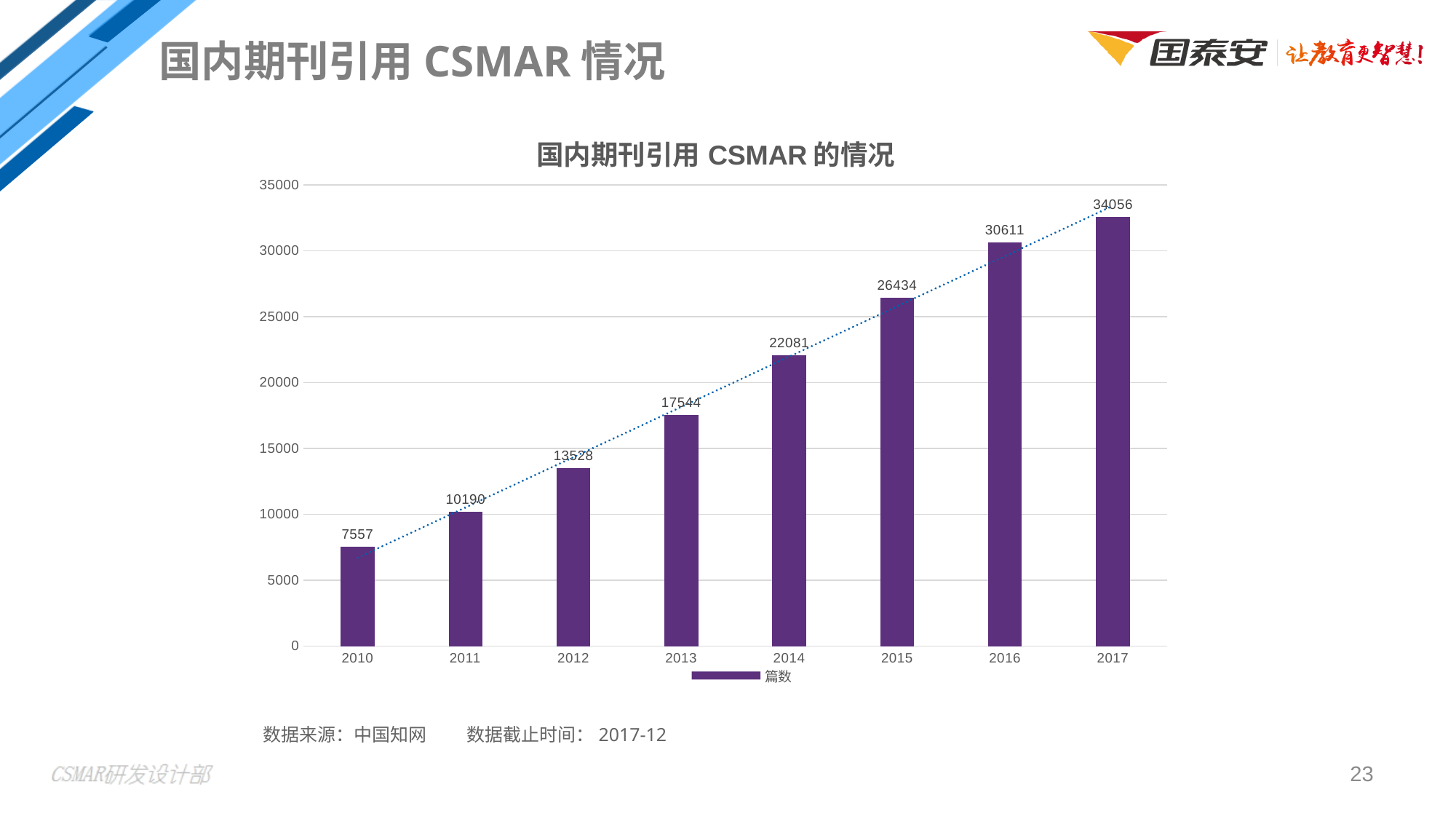
Do the values rise or fall from 2010 to 2017? rise What is the difference between the values for 2013 and 2012? 4016 Which year has the highest value? 2017 What kind of chart is this? bar chart Which year has the lowest value? 2010 Is the value for 2016 greater or less than 30000? greater What is the value for 2010? 7557 What is the value for 2017? 34056 What is the difference between the values for 2017 and 2016? 3445 How many years are shown on the x axis? 8 What is the value for 2014? 22081 Which is larger, the value for 2015 or the value for 2014? 2015